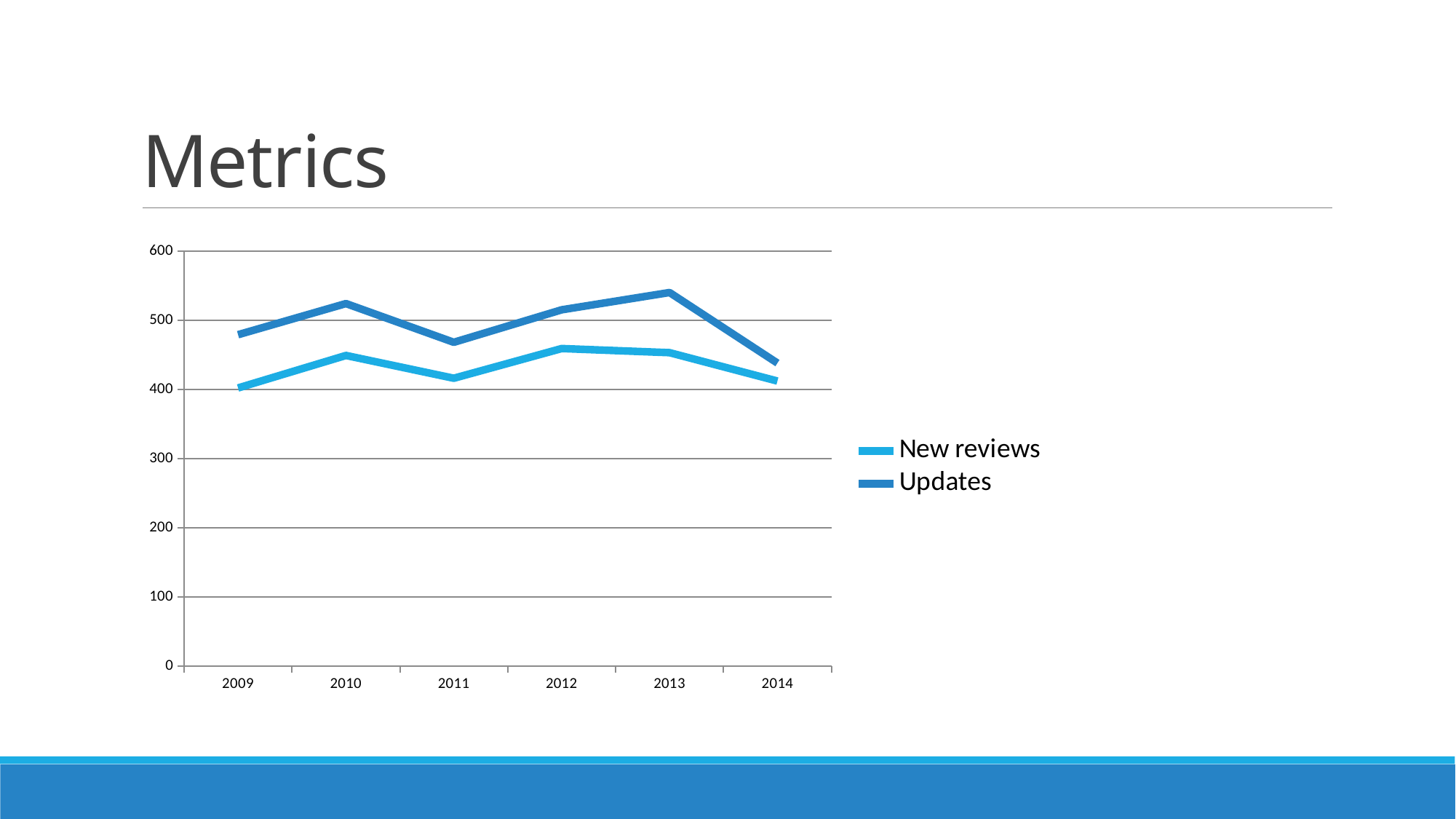
In which year is the Updates series at its lowest? 2014 Is the value for New reviews in 2010 greater or less than 400? greater How many series does the legend list? 2 Does the Updates series rise or fall from 2013 to 2014? fall How many years are plotted along the x axis? 6 In 2012, which series has the larger value, New reviews or Updates? Updates In which year is the Updates series at its highest? 2013 What is the title of the slide containing the chart? Metrics Is the value for New reviews in 2012 greater or less than 500? less What kind of chart is shown on the slide? line chart Is the value for Updates in 2014 greater or less than 500? less